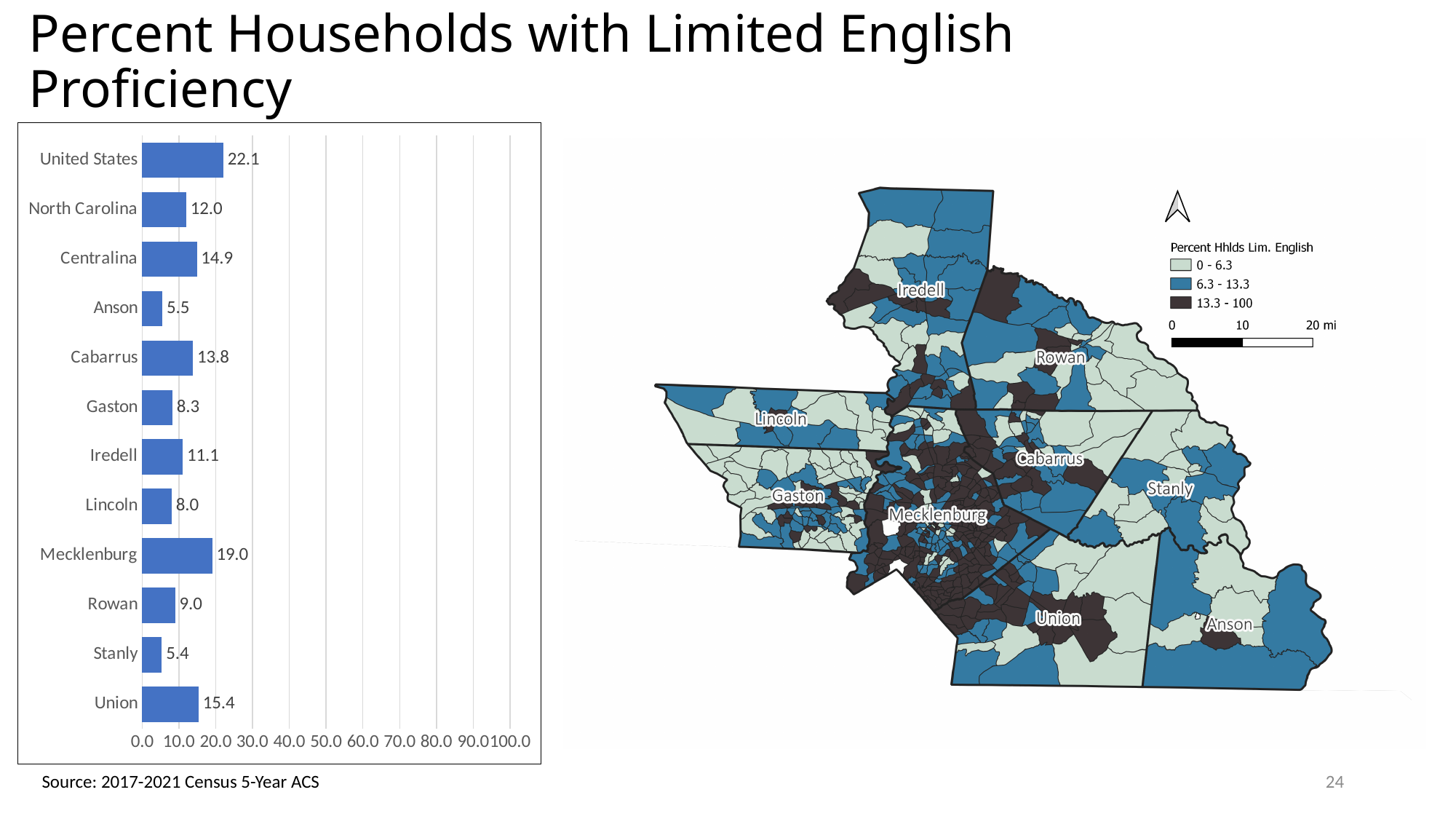
What is the value for Gaston in the bar chart? 8.3 What is the value for Union in the bar chart? 15.4 What is the value for North Carolina in the bar chart? 12.0 What is the highest value shown on the x axis of the bar chart? 100.0 What is the value for Mecklenburg in the bar chart? 19.0 In the bar chart, is the value for Centralina greater or less than 10.0? greater Which category has the highest value in the bar chart? United States What is the difference between the United States and North Carolina values in the bar chart? 10.1 What is the difference between the Mecklenburg and Union values in the bar chart? 3.6 In the bar chart, which is larger, the value for Cabarrus or the value for Iredell? Cabarrus How many categories are shown in the bar chart? 12 What kind of chart is shown on the left of the slide? bar chart